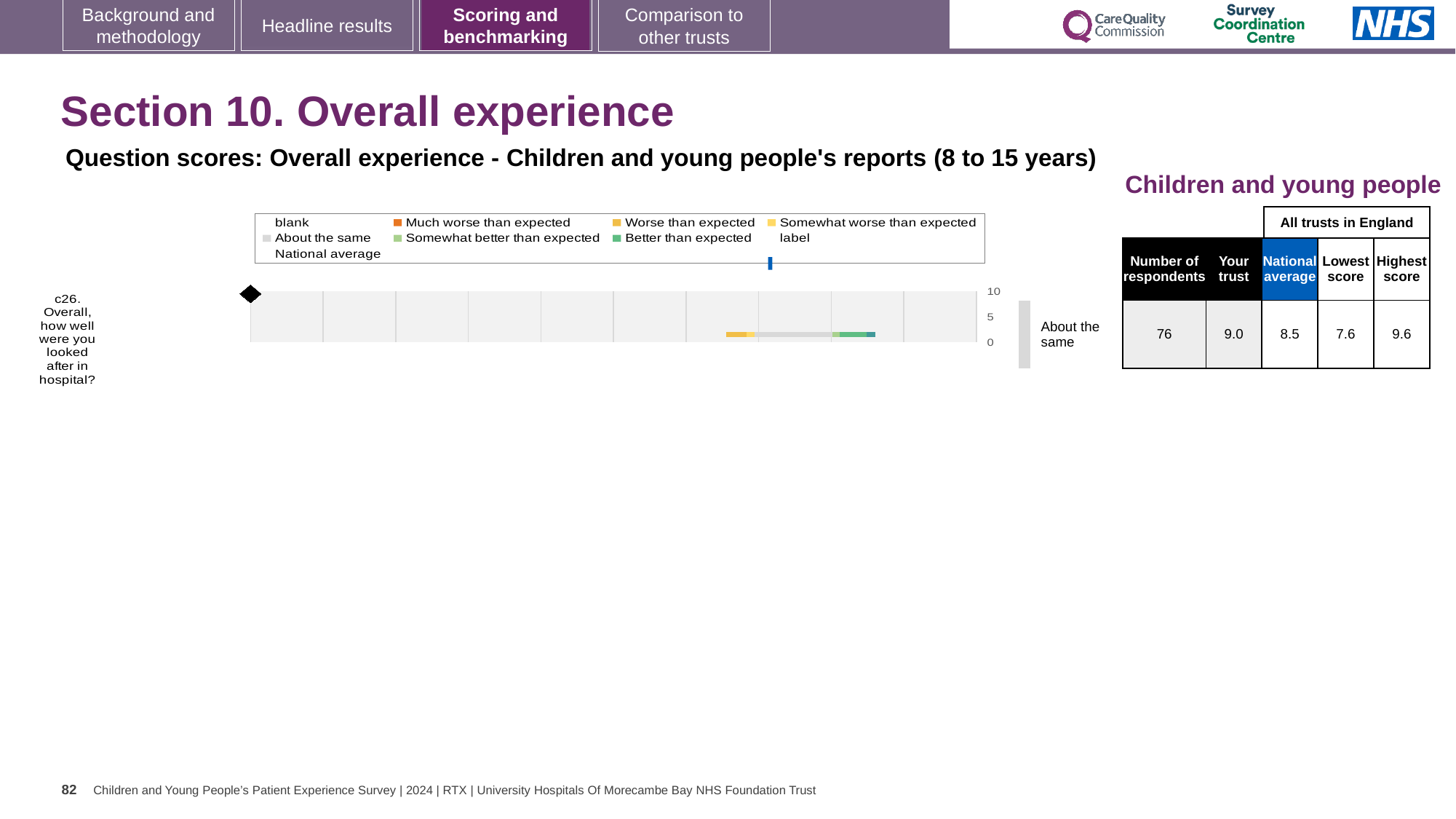
Which is higher for question c26: the 'Your trust' score or the national average? Your trust What is the maximum value shown on the chart's score axis? 10 What is the difference between the 'Your trust' score and the national average for question c26? 0.5 What is the 'Your trust' score for question c26? 9.0 What kind of chart is used to show the c26 question score? Bar chart What is the lowest score among all trusts in England for question c26? 7.6 Which question is plotted on the chart? c26. Overall, how well were you looked after in hospital? What benchmark category is shown next to the chart for question c26? About the same What is the highest score among all trusts in England for question c26? 9.6 How many respondents answered question c26? 76 How many survey questions are plotted on the chart? 1 What is the national average score for question c26? 8.5